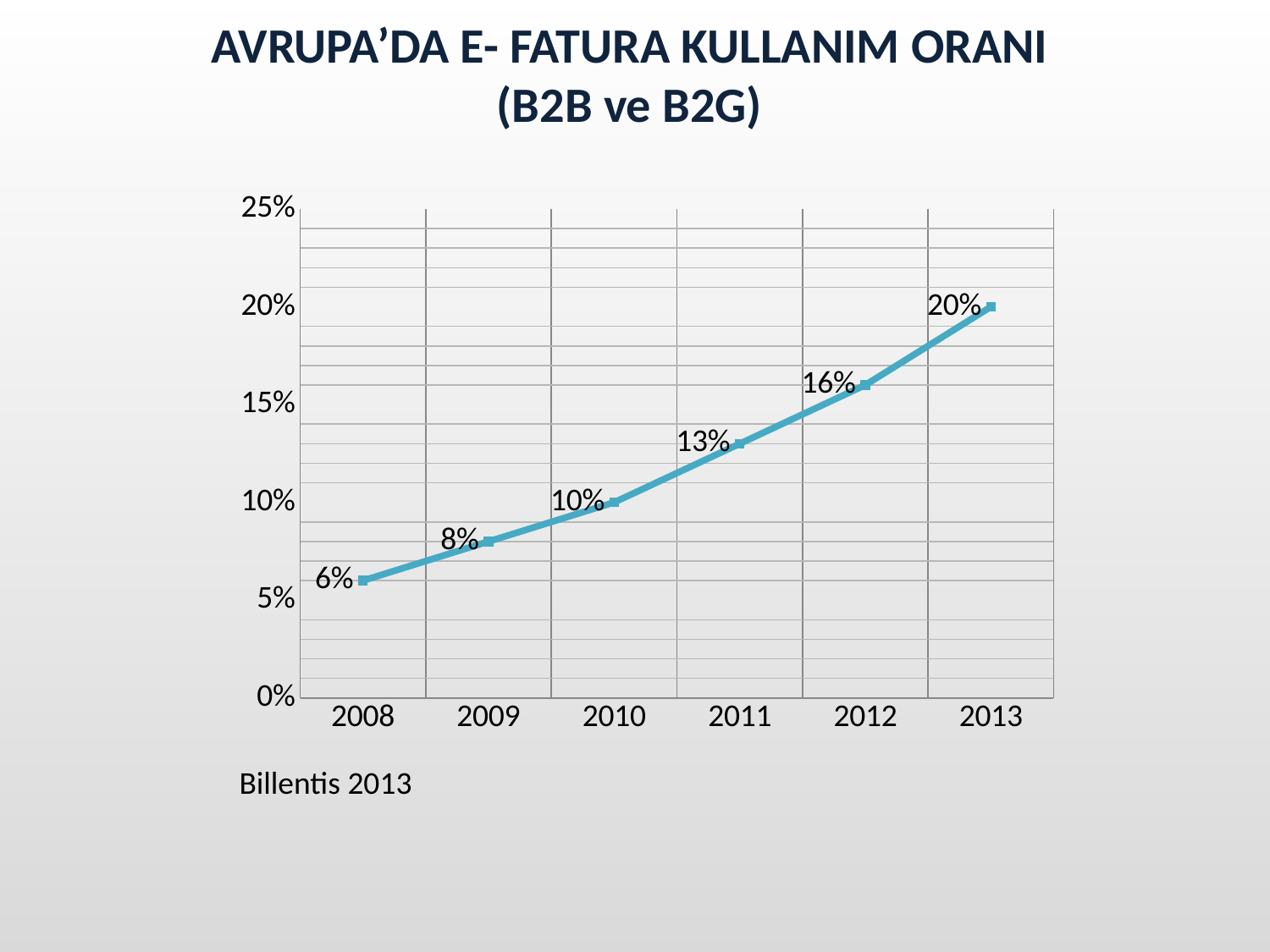
Is the value for 2011 greater or less than 15%? less What is the difference between the values for 2012 and 2010? 6% Which year has the highest value? 2013 Which year has the lowest value? 2008 How many years are plotted on the chart? 6 Do the values rise or fall from 2008 to 2013? rise What is the value for 2008? 6% What is the difference between the values for 2013 and 2008? 14% What is the value for 2013? 20% What kind of chart is shown on the slide? line chart What is the value for 2011? 13% Which is larger, the value for 2009 or the value for 2012? 2012